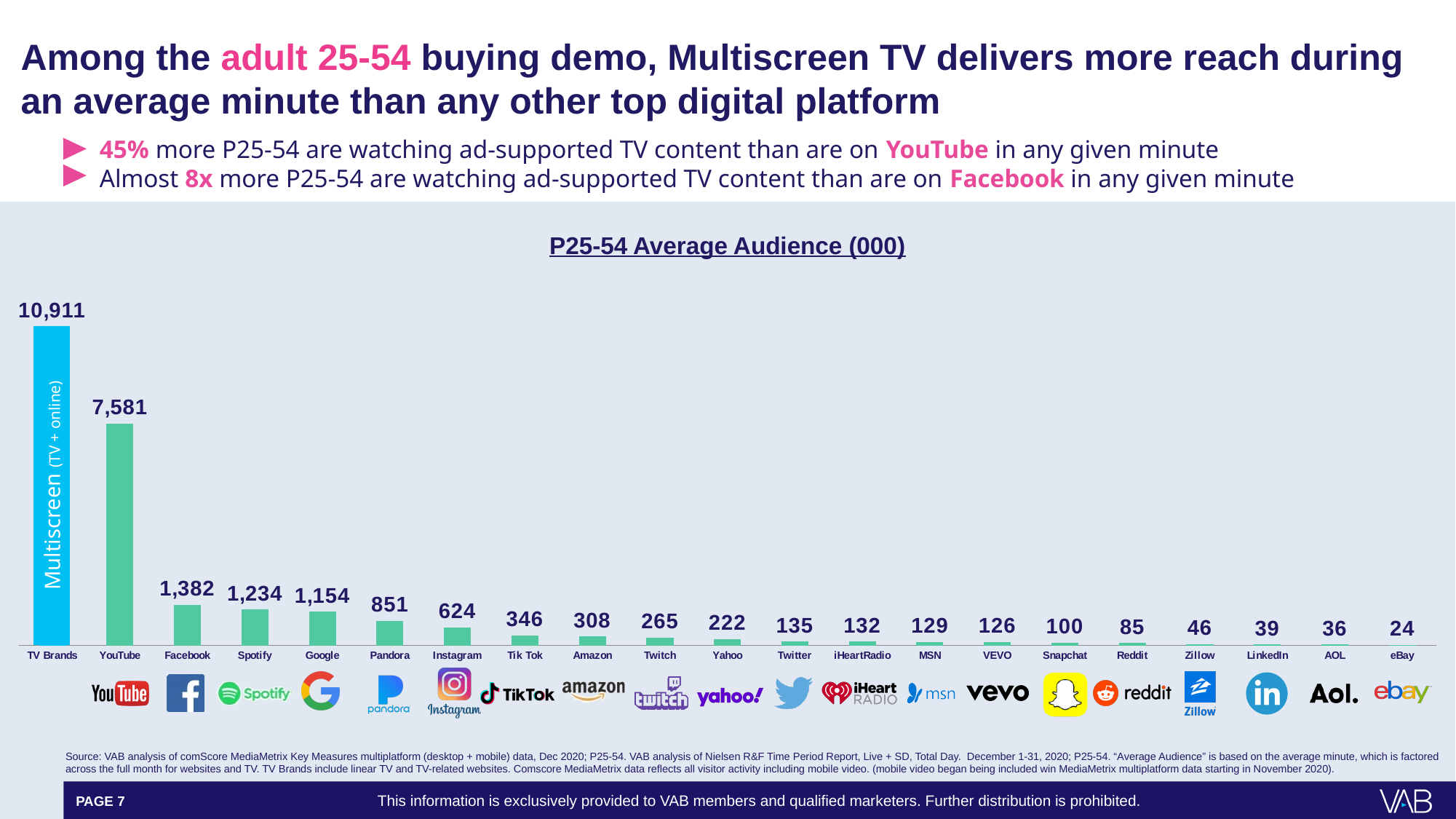
What is the title of the chart? P25-54 Average Audience (000) What is the P25-54 average audience (000) for Facebook? 1,382 Which has a larger P25-54 average audience, Pandora or Instagram? Pandora What is the difference between the TV Brands and YouTube values? 3,330 What kind of chart is shown on the slide? Bar chart Which category has the highest P25-54 average audience? TV Brands What is the difference between the Spotify and Google values? 80 Which category has the lowest P25-54 average audience? eBay How many categories are shown in the chart? 21 What is the P25-54 average audience (000) for Tik Tok? 346 What is the P25-54 average audience (000) for YouTube? 7,581 What is the P25-54 average audience (000) for TV Brands? 10,911